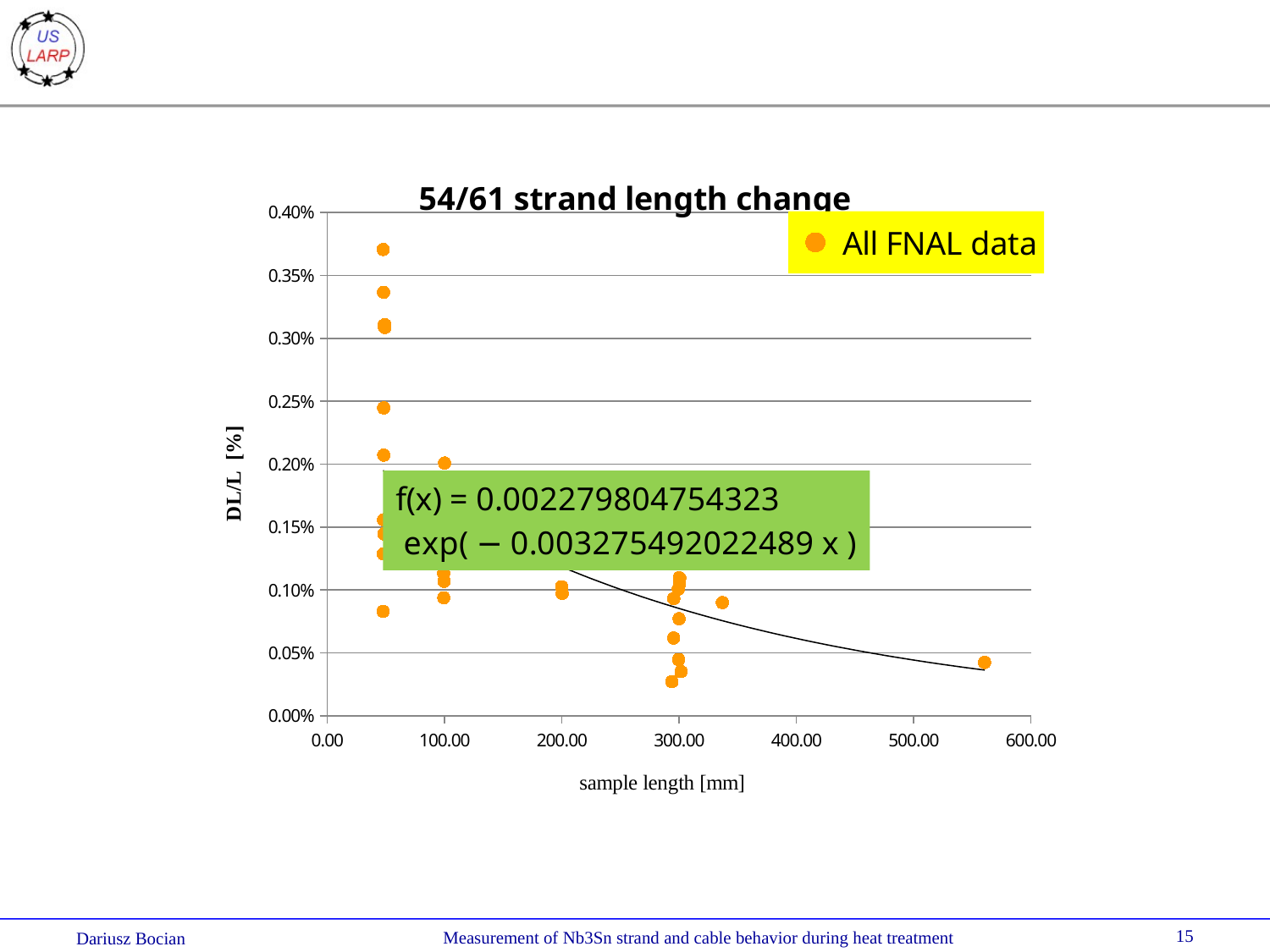
Is the DL/L value of the point near 560 mm sample length greater or less than 0.10%? less According to the fitted trendline, do DL/L values rise or fall as sample length increases? fall Is the lowest DL/L value plotted greater or less than 0.05%? less What is the title of the chart? 54/61 strand length change What kind of chart is shown on the slide? scatter chart Which has the larger DL/L value: the highest point near 50 mm or the point near 560 mm? the point near 50 mm How many series does the legend list? 1 Is the DL/L value of the point near 335 mm sample length greater or less than 0.05%? greater What is the name of the series shown in the legend? All FNAL data